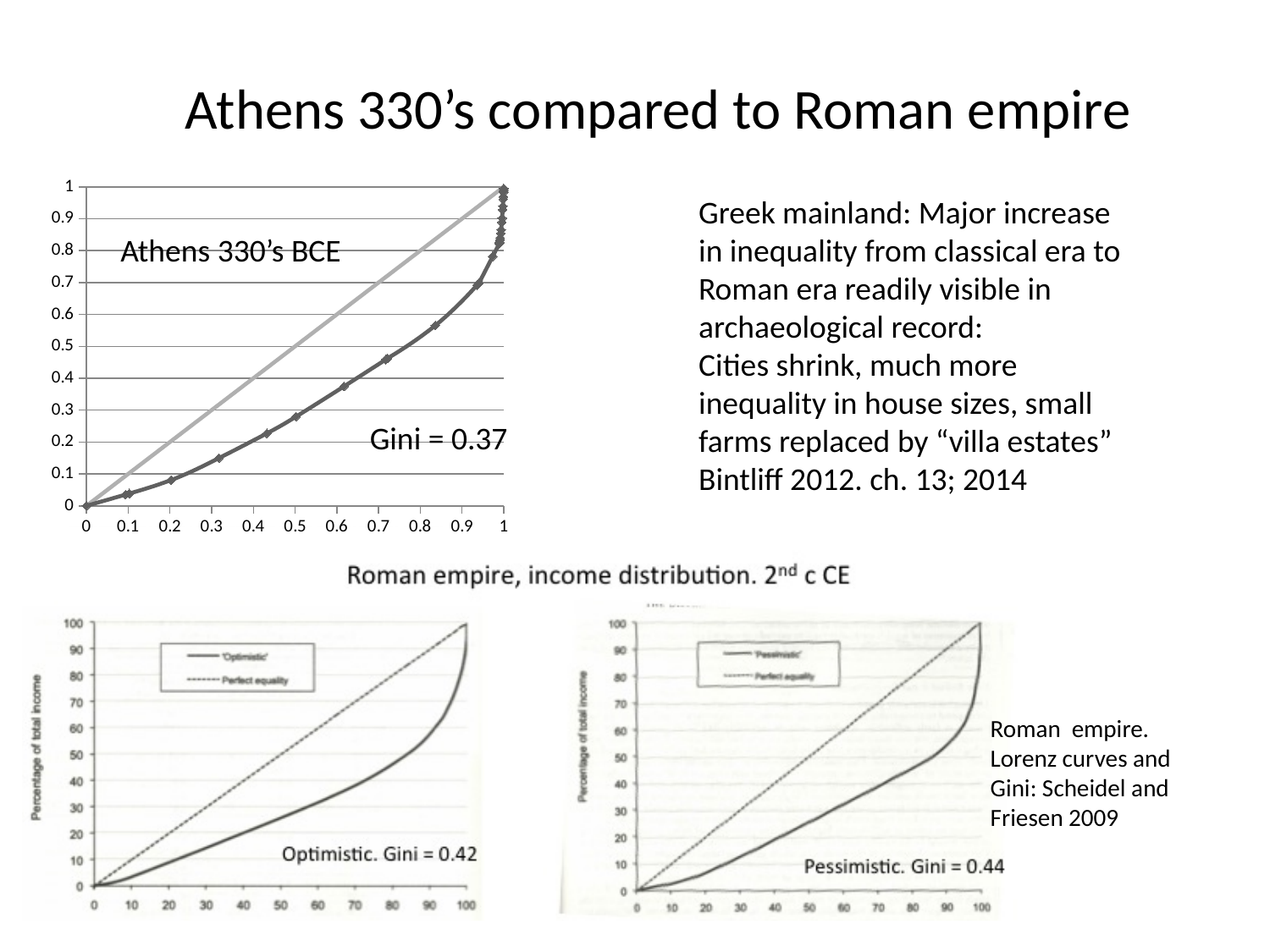
On the Roman empire Pessimistic chart (bottom right), what is the Gini value shown? 0.44 Of the three Gini values shown on the slide, which chart has the lowest? Athens 330's BCE What is the difference between the Pessimistic Roman empire Gini and the Athens 330's BCE Gini? 0.07 What is the difference between the Pessimistic Gini and the Optimistic Gini on the Roman empire charts? 0.02 On the Roman empire Optimistic chart, how many series does the legend list? 2 On the Athens 330's BCE chart, what is the Gini coefficient shown? 0.37 On the Roman empire Optimistic chart (bottom left), what is the Gini value shown? 0.42 What kind of chart is the Athens 330's BCE chart? Line chart (Lorenz curve) On the Athens 330's BCE chart, is the value of the Lorenz curve at x = 0.3 greater or less than 0.2? less What is the y-axis label on the Roman empire Optimistic chart? Percentage of total income Of the two Roman empire charts, which scenario has the higher Gini value? Pessimistic On the Athens 330's BCE chart, is the value of the Lorenz curve at x = 0.7 greater or less than 0.4? greater